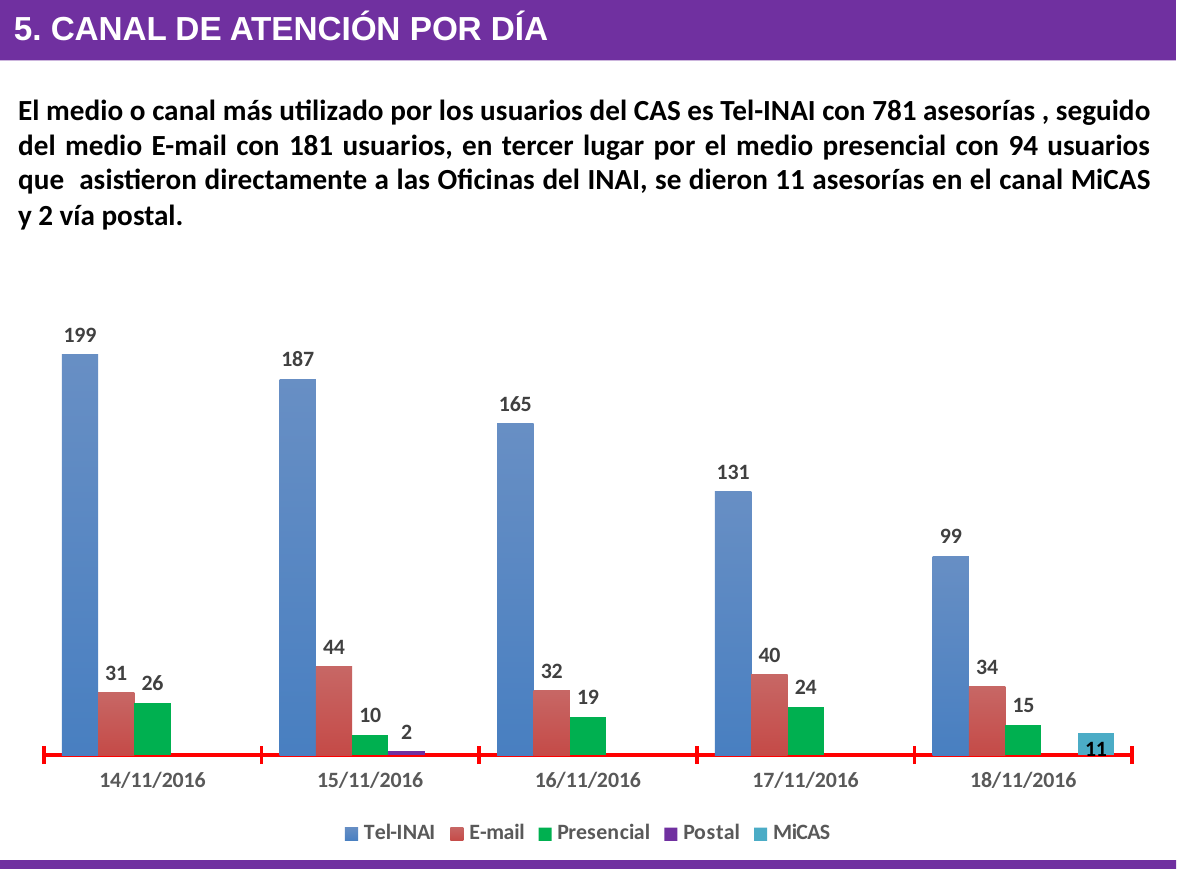
On which date is the Tel-INAI value lowest? 18/11/2016 What kind of chart is shown on the slide? bar chart What is the E-mail value for 15/11/2016? 44 What is the Presencial value for 17/11/2016? 24 How many dates are shown on the x axis? 5 On which date is the Tel-INAI value highest? 14/11/2016 Which is larger, the E-mail value for 16/11/2016 or the E-mail value for 17/11/2016? 17/11/2016 What is the MiCAS value for 18/11/2016? 11 Do the Tel-INAI values rise or fall from 14/11/2016 to 18/11/2016? fall What is the Tel-INAI value for 14/11/2016? 199 What is the difference between the Tel-INAI values for 14/11/2016 and 18/11/2016? 100 How many series does the legend list? 5